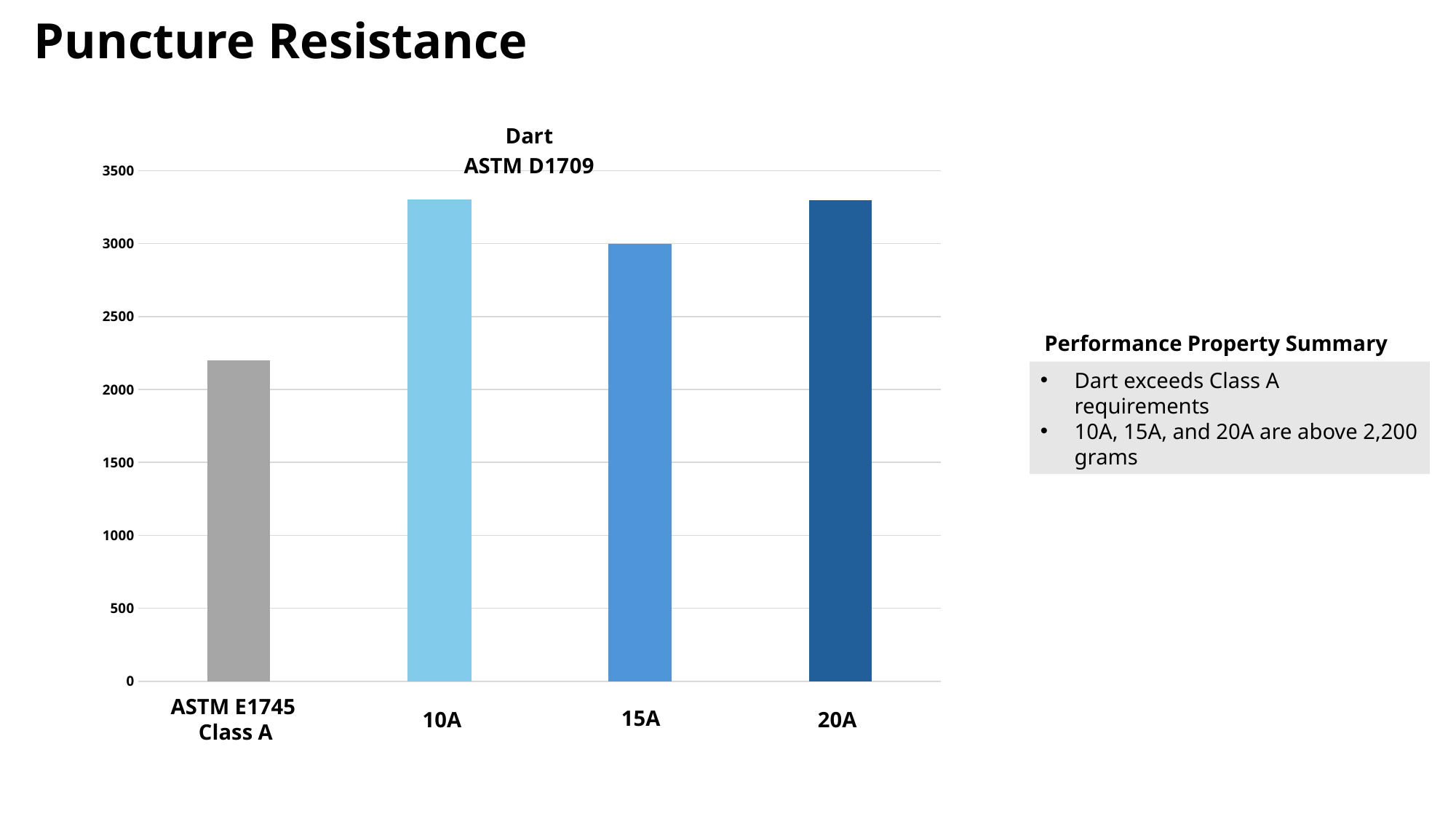
Which is larger, the value for 20A or the value for ASTM E1745 Class A? 20A Which category has the lowest value in the chart? ASTM E1745 Class A What is the title of the chart? Dart ASTM D1709 What colour is the bar for ASTM E1745 Class A? grey Which is larger, the value for 10A or the value for 15A? 10A What is the value for 15A? 3000 What kind of chart is shown on the slide? bar chart Is the value for ASTM E1745 Class A greater or less than 2000? greater How many bars are plotted in the chart? 4 Is the value for 10A greater or less than 3000? greater Is the value for ASTM E1745 Class A greater or less than 2500? less